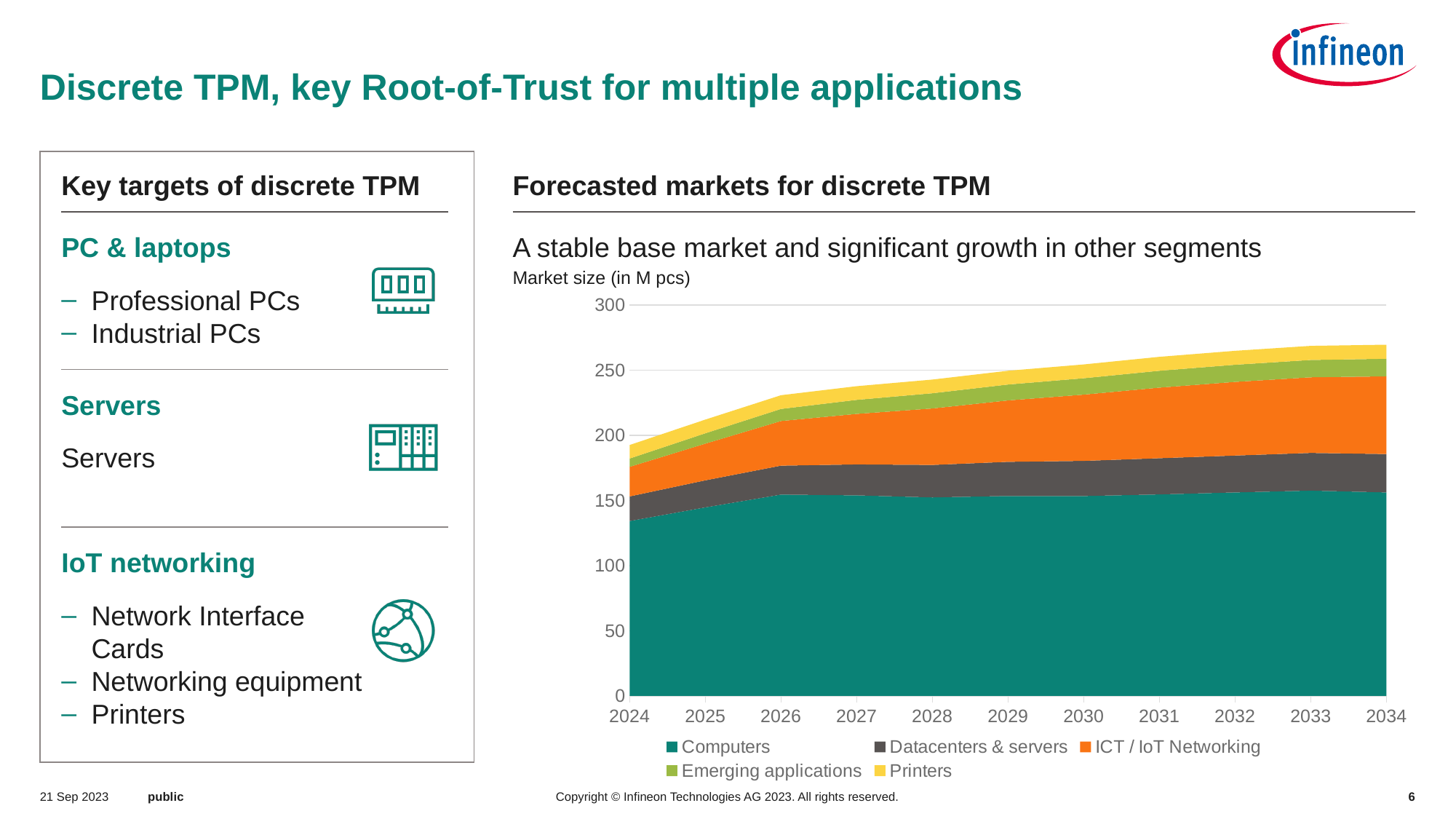
Is the total market size in 2034 greater or less than 250 M pcs? greater Is the total market size in 2026 greater or less than 200 M pcs? greater How many years are shown on the x axis of the forecasted markets chart? 11 What kind of chart is shown under "Forecasted markets for discrete TPM"? Stacked area chart Which is larger, the total market size in 2034 or in 2024? 2034 Is the total market size in 2024 greater or less than 200 M pcs? less Which series makes up the largest share of the forecasted market in every year? Computers How many series does the legend of the forecasted markets chart list? 5 Does the total forecasted market size rise or fall from 2024 to 2034? rise What unit is the market size measured in on the forecasted markets chart? M pcs Which years does the x axis of the forecasted markets chart span? 2024 to 2034